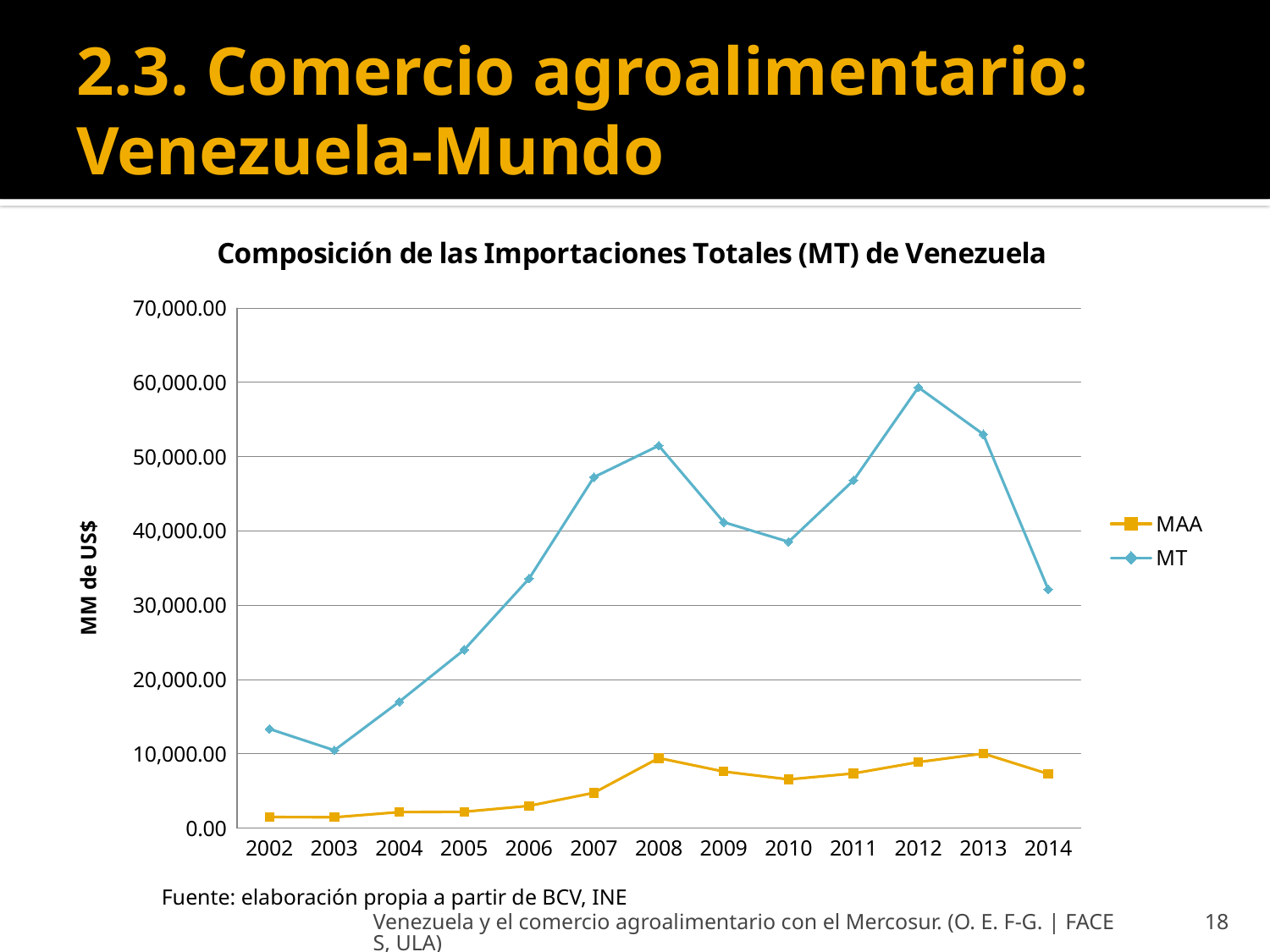
Is the MT value for 2010 greater or less than 40,000.00? less In which year does the MT series reach its lowest value? 2003 What kind of chart is shown on the slide? line chart How many years are plotted along the x axis? 13 Is the MAA value for 2008 greater or less than 10,000.00? less What is the label on the y axis? MM de US$ Is the MT value for 2012 greater or less than 50,000.00? greater Does the MT series rise or fall from 2012 to 2014? fall In which year does the MT series reach its highest value? 2012 How many series does the legend list? 2 In which year does the MAA series reach its highest value? 2013 Which is larger, the MT value for 2008 or the MT value for 2011? 2008